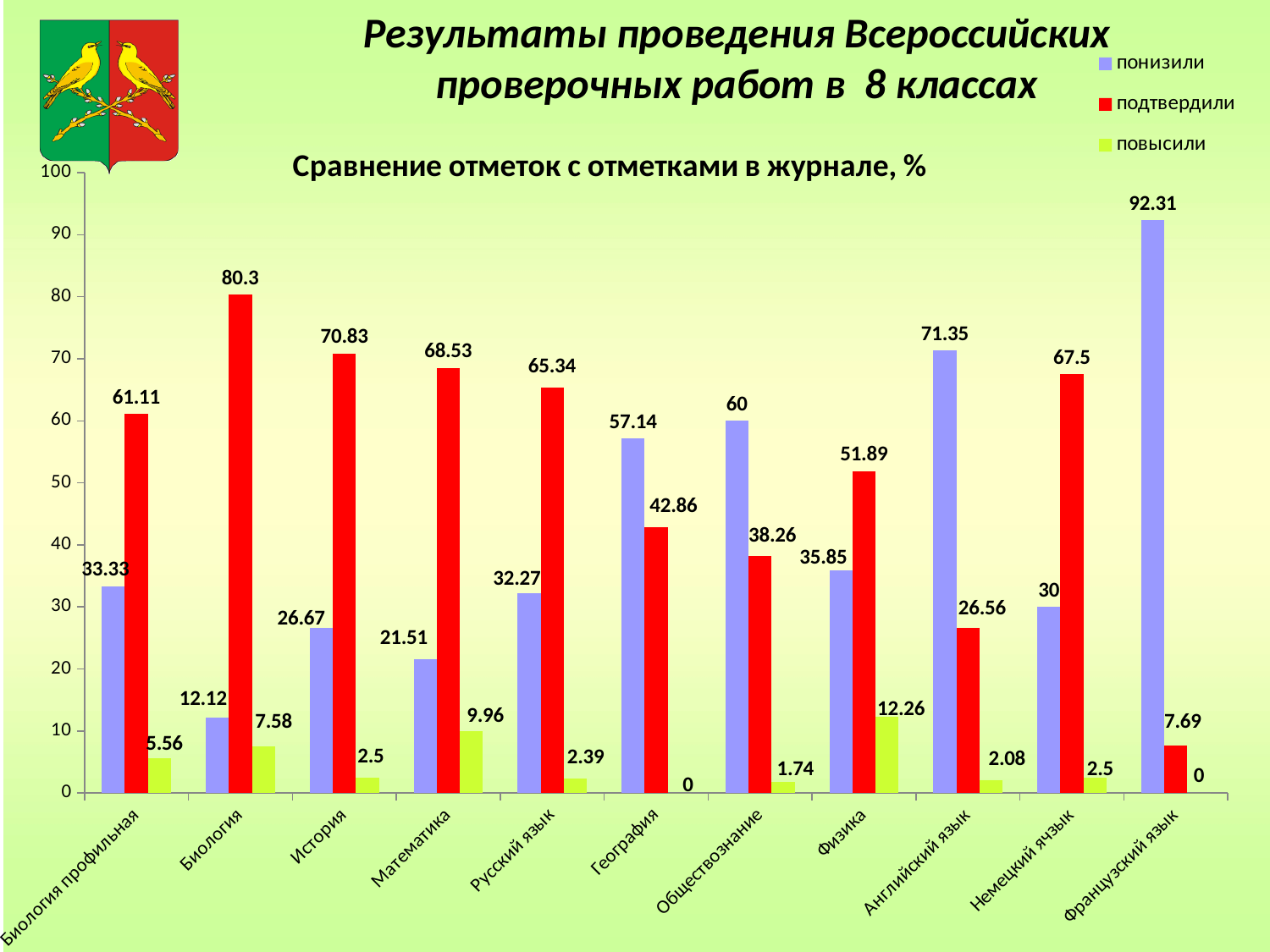
How many series does the legend list? 3 Which subject has the highest value for "понизили"? Французский язык What is the value of "подтвердили" for Биология? 80.3 What is the title of the chart? Сравнение отметок с отметками в журнале, % What is the value of "понизили" for Французский язык? 92.31 What is the difference between "подтвердили" and "понизили" for История? 44.16 What is the value of "повысили" for Физика? 12.26 What type of chart is shown on the slide? bar chart For География, which is larger: "понизили" or "подтвердили"? понизили Is the value of "подтвердили" for Физика greater or less than 50? greater Which subject has the lowest value for "подтвердили"? Французский язык How many subjects are shown on the x axis? 11